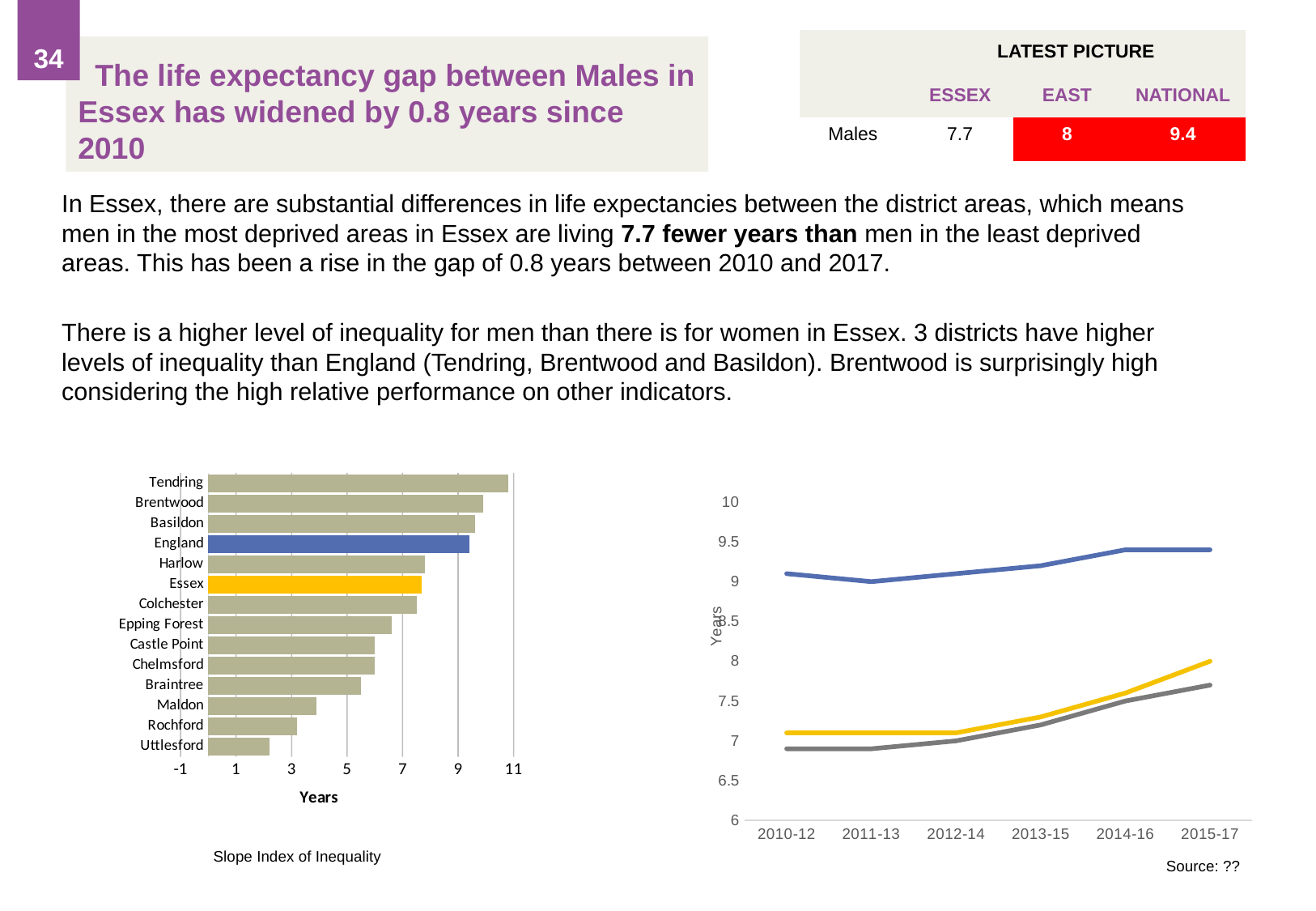
How many time periods are shown on the x axis of the line chart on the right? 6 How many areas are shown in the Slope Index of Inequality bar chart? 14 In the Slope Index of Inequality bar chart, which area has the highest value? Tendring What type of chart is the chart on the right of the slide? line chart In the Slope Index of Inequality bar chart, is the value for Maldon greater or less than 5? less What type of chart is the Slope Index of Inequality chart on the left? bar chart In the Slope Index of Inequality bar chart, which is larger, the value for England or the value for Essex? England In the Slope Index of Inequality bar chart, is the value for Uttlesford greater or less than 3? less What is the x-axis title of the Slope Index of Inequality bar chart? Years In the Slope Index of Inequality bar chart, which area has the lowest value? Uttlesford In the Slope Index of Inequality bar chart, is the value for Tendring greater or less than 9? greater In the Slope Index of Inequality bar chart, which is larger, the value for Harlow or the value for Rochford? Harlow